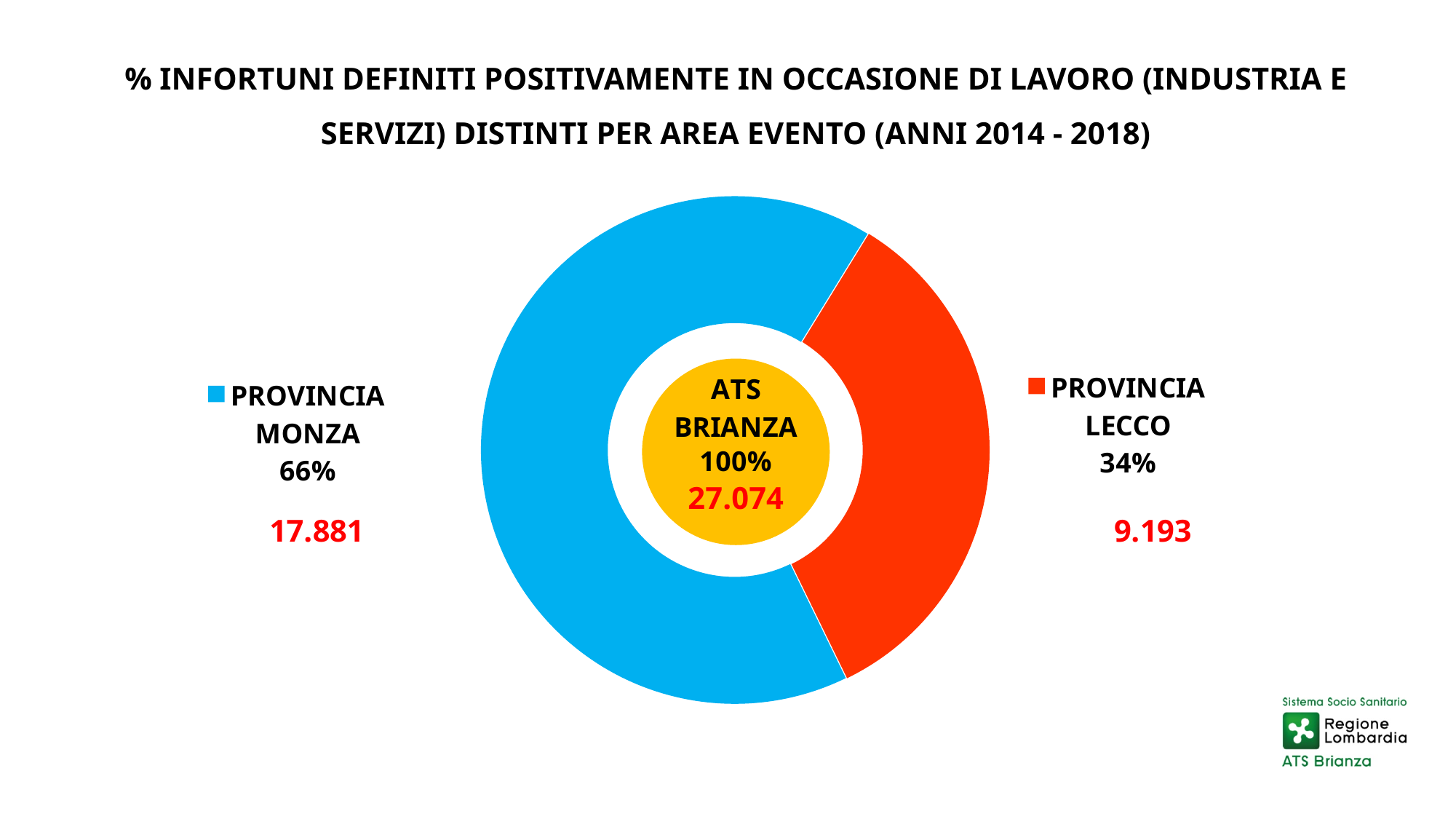
How many categories (provinces) are shown in the chart? 2 Is the value for PROVINCIA LECCO larger or smaller than the value for PROVINCIA MONZA? smaller What total is shown in the centre of the chart for ATS BRIANZA? 27.074 What kind of chart is shown on the slide? pie chart (doughnut) What is the difference in percentage points between PROVINCIA MONZA and PROVINCIA LECCO? 32 Which province has the larger share of the pie chart? PROVINCIA MONZA Which province has the smaller share of the pie chart? PROVINCIA LECCO What percentage share does PROVINCIA MONZA have in the pie chart? 66% What colour represents PROVINCIA LECCO in the chart? red What percentage share does PROVINCIA LECCO have in the pie chart? 34% What is the number of injuries shown for PROVINCIA MONZA? 17.881 What is the number of injuries shown for PROVINCIA LECCO? 9.193